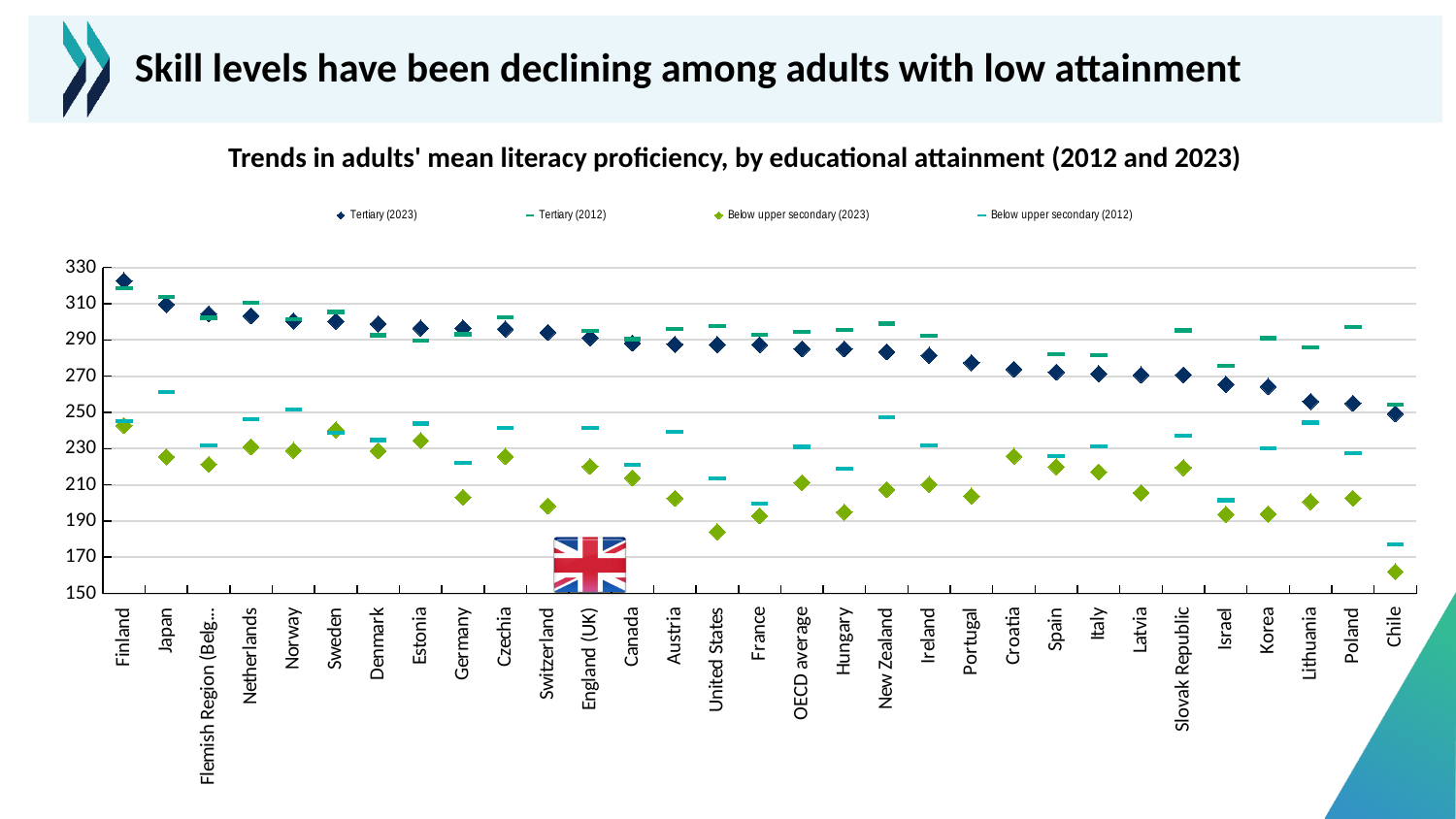
Is the Below upper secondary (2023) value for Chile greater or less than 170? less Which country has the highest Tertiary (2023) value? Finland How many countries/regions are shown along the x axis? 31 What is the title of the chart? Trends in adults' mean literacy proficiency, by educational attainment (2012 and 2023) Which country has the lowest Below upper secondary (2023) value? Chile How many series does the legend list? 4 Is the Tertiary (2023) value for Finland greater or less than 310? greater Do the Tertiary (2023) values generally rise or fall from left to right along the x axis? fall What kind of chart is shown on the slide? Scatter chart Is the Below upper secondary (2023) value for the United States greater or less than 190? less Which country has the lowest Tertiary (2023) value? Chile Which has the larger Below upper secondary (2023) value, Germany or Czechia? Czechia